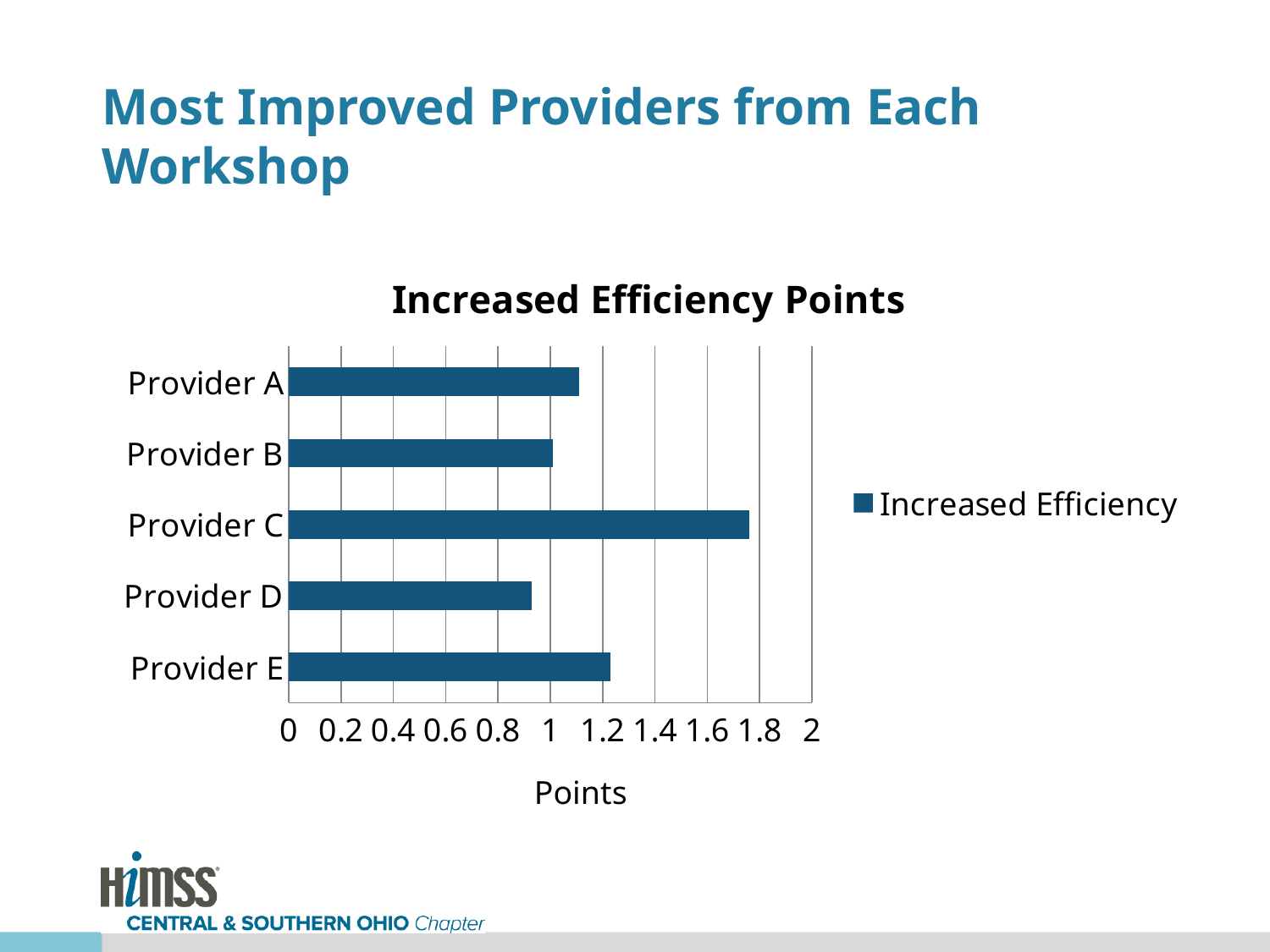
Which has a larger Increased Efficiency value, Provider C or Provider A? Provider C Which provider has the highest Increased Efficiency value? Provider C What is the title of the chart? Increased Efficiency Points Is the value for Provider C greater or less than 1.6? greater Which has a larger Increased Efficiency value, Provider E or Provider D? Provider E How many series does the legend list? 1 Is the value for Provider D greater or less than 1? less What kind of chart is shown on the slide? bar chart How many providers are shown in the chart? 5 Is the value for Provider A greater or less than 1? greater Which provider has the lowest Increased Efficiency value? Provider D What is the label of the horizontal axis? Points